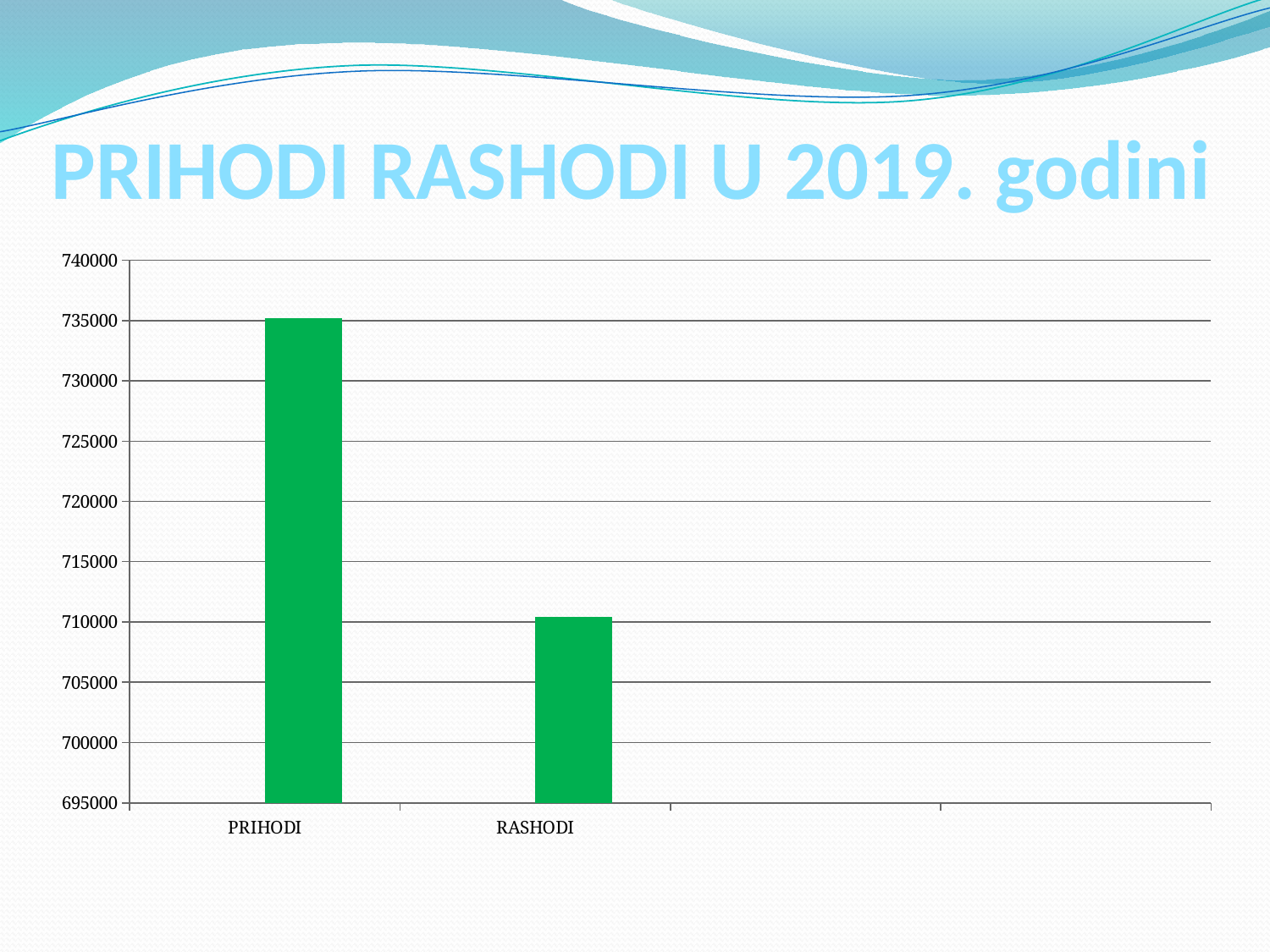
Is the value for PRIHODI greater or less than 730000? greater Is the value for PRIHODI greater or less than 740000? less What is the title of the slide containing the chart? PRIHODI RASHODI U 2019. godini How many categories are shown on the x axis? 2 Is the value for RASHODI greater or less than 705000? greater Which is larger, the value for PRIHODI or the value for RASHODI? PRIHODI Do the values rise or fall from PRIHODI to RASHODI along the x axis? fall What kind of chart is shown on the slide? bar chart Which category has the highest value? PRIHODI Which category has the lowest value? RASHODI What colour are the bars in the chart? green